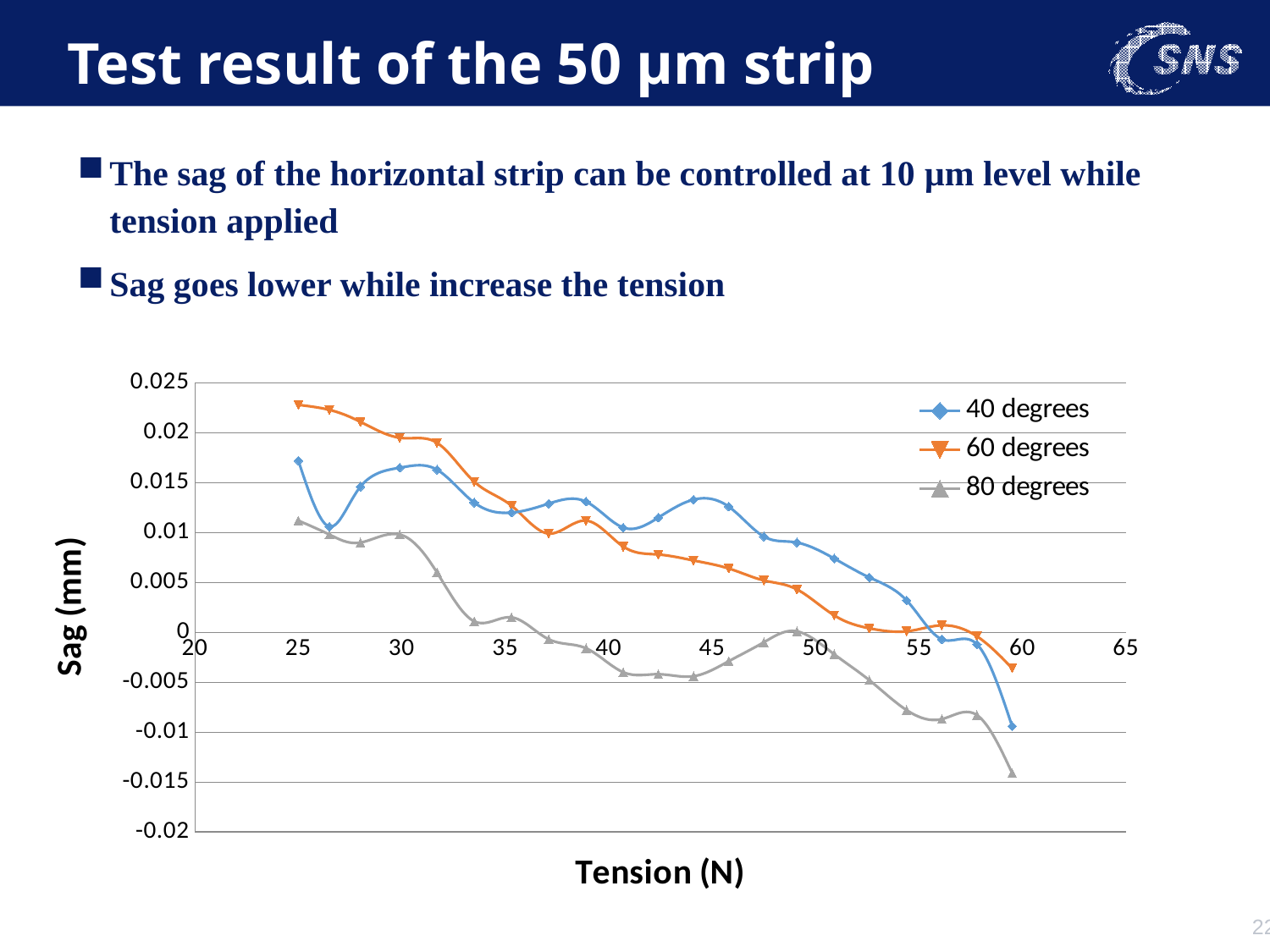
Overall, does the sag for the 60 degrees series rise or fall as tension increases? fall Is the sag for the 80 degrees series at a tension of 60 N greater or less than -0.01? less Is the sag for the 60 degrees series at a tension of 25 N greater or less than 0.02? greater Is the sag for the 80 degrees series at a tension of 25 N greater or less than 0.005? greater At a tension of 25 N, which series has the higher sag, 40 degrees or 60 degrees? 60 degrees What are the three series named in the chart legend? 40 degrees, 60 degrees, 80 degrees How many series does the chart legend list? 3 Overall, does the sag for the 80 degrees series rise or fall as tension increases? fall What kind of chart is shown on the slide? line chart At a tension of 60 N, which series has the lowest sag? 80 degrees What is the title of the x axis of the chart? Tension (N)